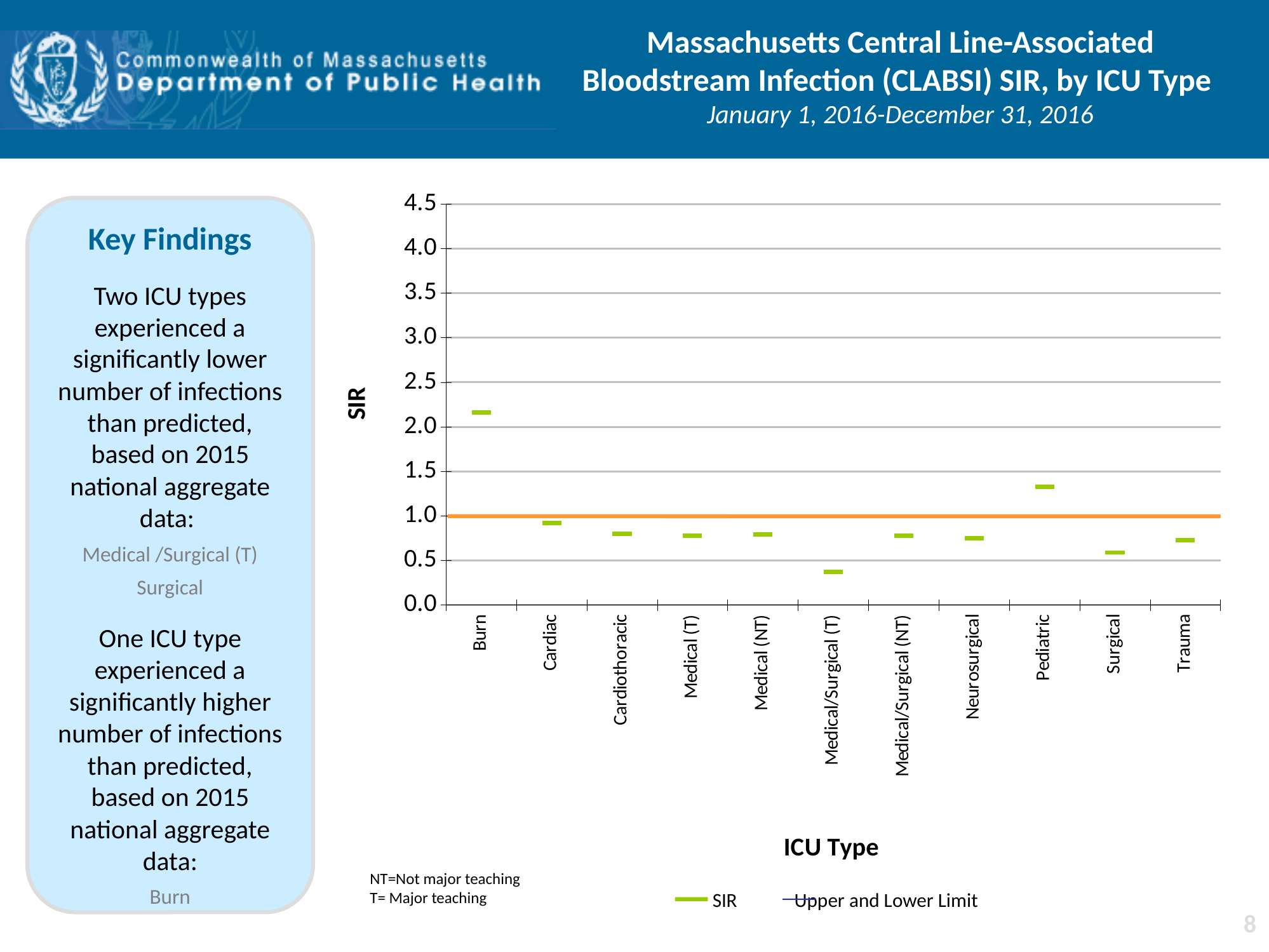
How many series does the chart legend list? 2 What is the title of the vertical axis of the chart? SIR How many ICU types are shown on the x axis of the chart? 11 Which has a higher SIR, Medical/Surgical (T) or Surgical? Surgical Which has a higher SIR, Burn or Pediatric? Burn Is the SIR value for Medical/Surgical (T) greater or less than 0.5? less Is the SIR value for Pediatric greater or less than 1.0? greater Is the SIR value for Trauma greater or less than 1.0? less Which ICU type has the highest SIR in the chart? Burn What is the title of the horizontal axis of the chart? ICU Type Which ICU type has the lowest SIR in the chart? Medical/Surgical (T)